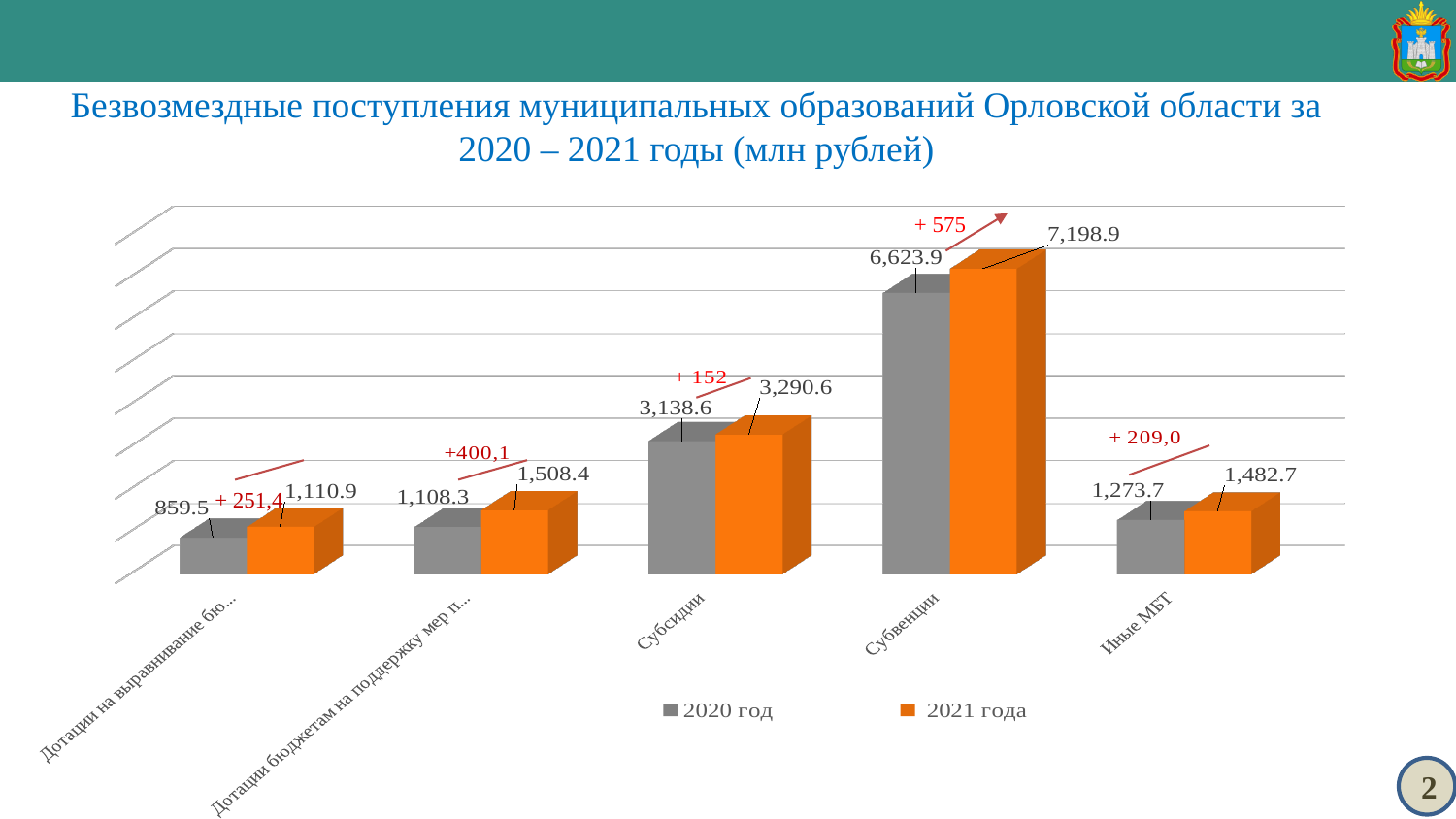
How many categories are shown on the x axis? 5 Which is larger for Субсидии: the 2020 год value or the 2021 года value? 2021 года What is the value for Иные МБТ in the 2021 года series? 1,482.7 Which category has the highest value in the 2021 года series? Субвенции What is the value for Субсидии in the 2020 год series? 3,138.6 What is the difference between the 2021 года and 2020 год values for Иные МБТ? 209.0 What is the difference between the 2021 года and 2020 год values for Субвенции? 575 How many series does the legend list? 2 What kind of chart is shown on the slide? Bar chart What is the value for Иные МБТ in the 2020 год series? 1,273.7 Which category has the lowest value in the 2020 год series? Дотации на выравнивание бю... (the first category) What is the value for Субвенции in the 2021 года series? 7,198.9